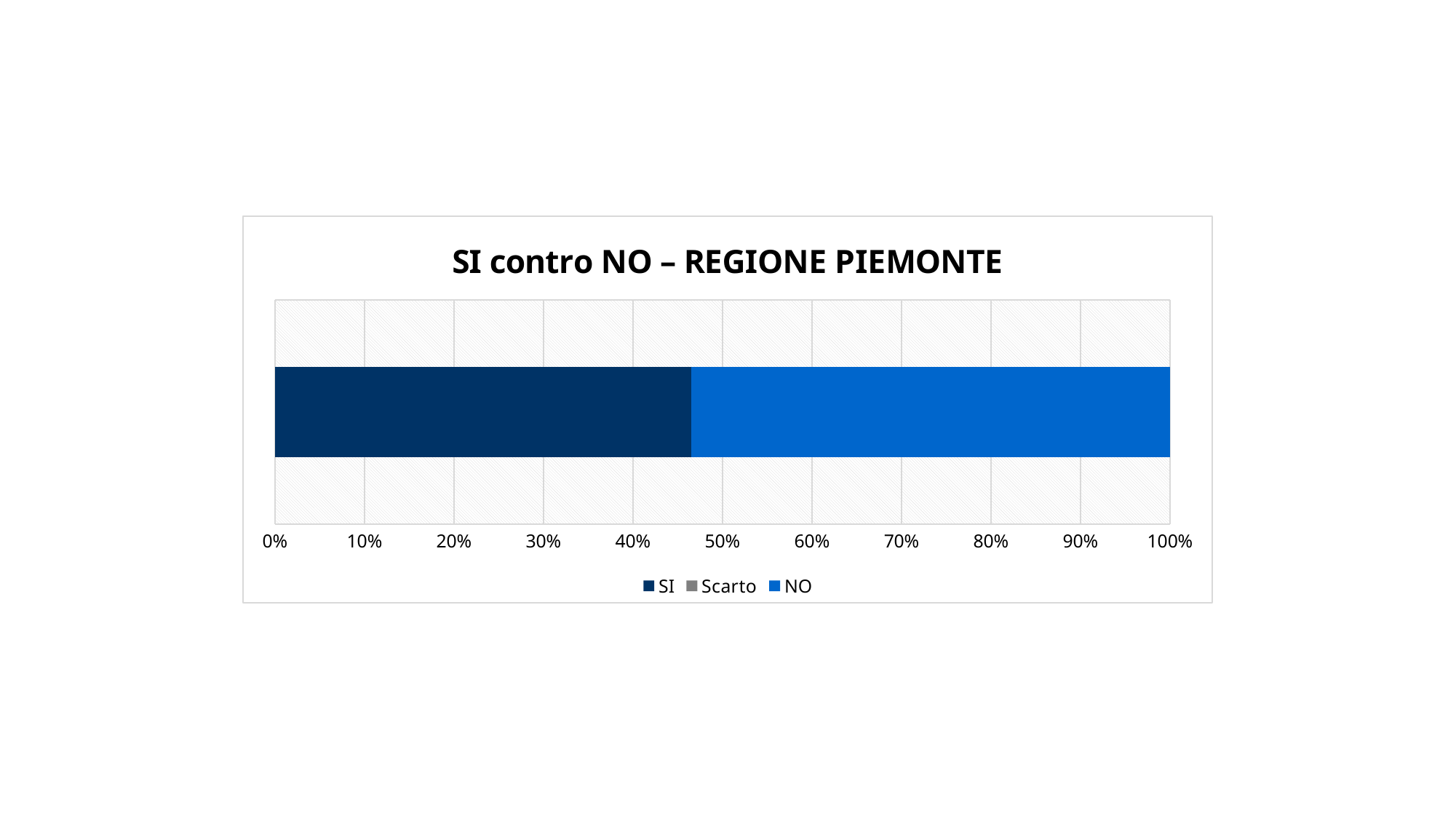
Is the value for NO greater or less than 60%? less What kind of chart is shown on the slide? bar chart How many bars are plotted in the chart? 1 Is the value for NO greater or less than 50%? greater What is the highest value shown on the horizontal axis? 100% Is the value for SI greater or less than 50%? less Which series are listed in the legend? SI, Scarto, NO What is the title of the chart? SI contro NO – REGIONE PIEMONTE How many series does the legend list? 3 Which series occupies the largest share of the bar? NO Which is larger, the SI segment or the NO segment? NO